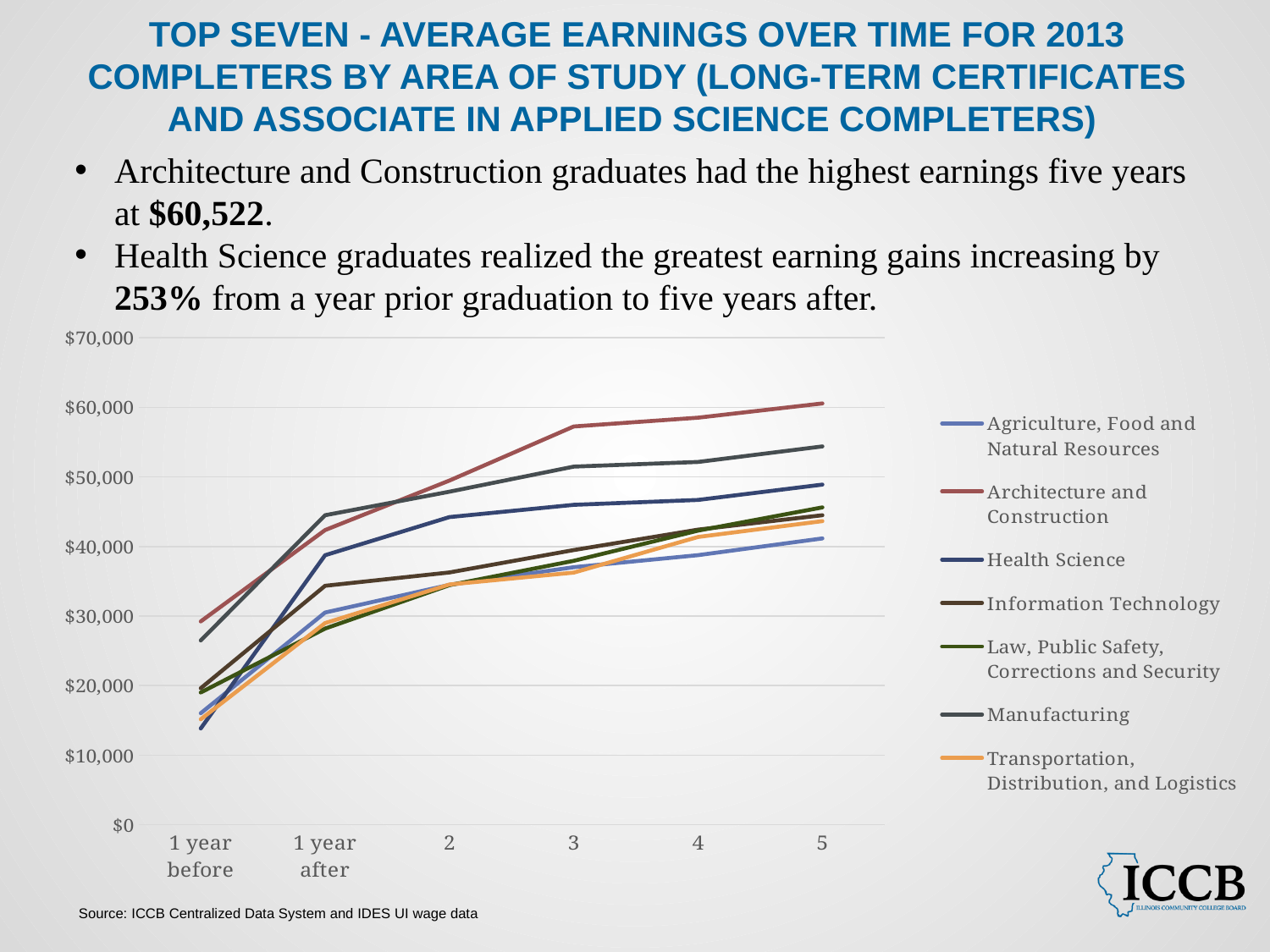
What colour is the Architecture and Construction line in the legend? red Which area of study has the lowest average earnings at year 5? Agriculture, Food and Natural Resources How many time points are shown along the x axis? 6 Do the average earnings for Architecture and Construction rise or fall from 1 year before to year 5? rise How many series does the legend list? 7 Which area of study has the highest average earnings at 1 year before? Architecture and Construction What were the average earnings of Architecture and Construction graduates five years after completion? $60,522 At year 5, which is larger: Manufacturing or Health Science? Manufacturing Is the value for Manufacturing at year 5 greater or less than $50,000? greater What kind of chart is shown on the slide? line chart Which area of study has the highest average earnings at year 5? Architecture and Construction Is the value for Agriculture, Food and Natural Resources at year 5 greater or less than $50,000? less